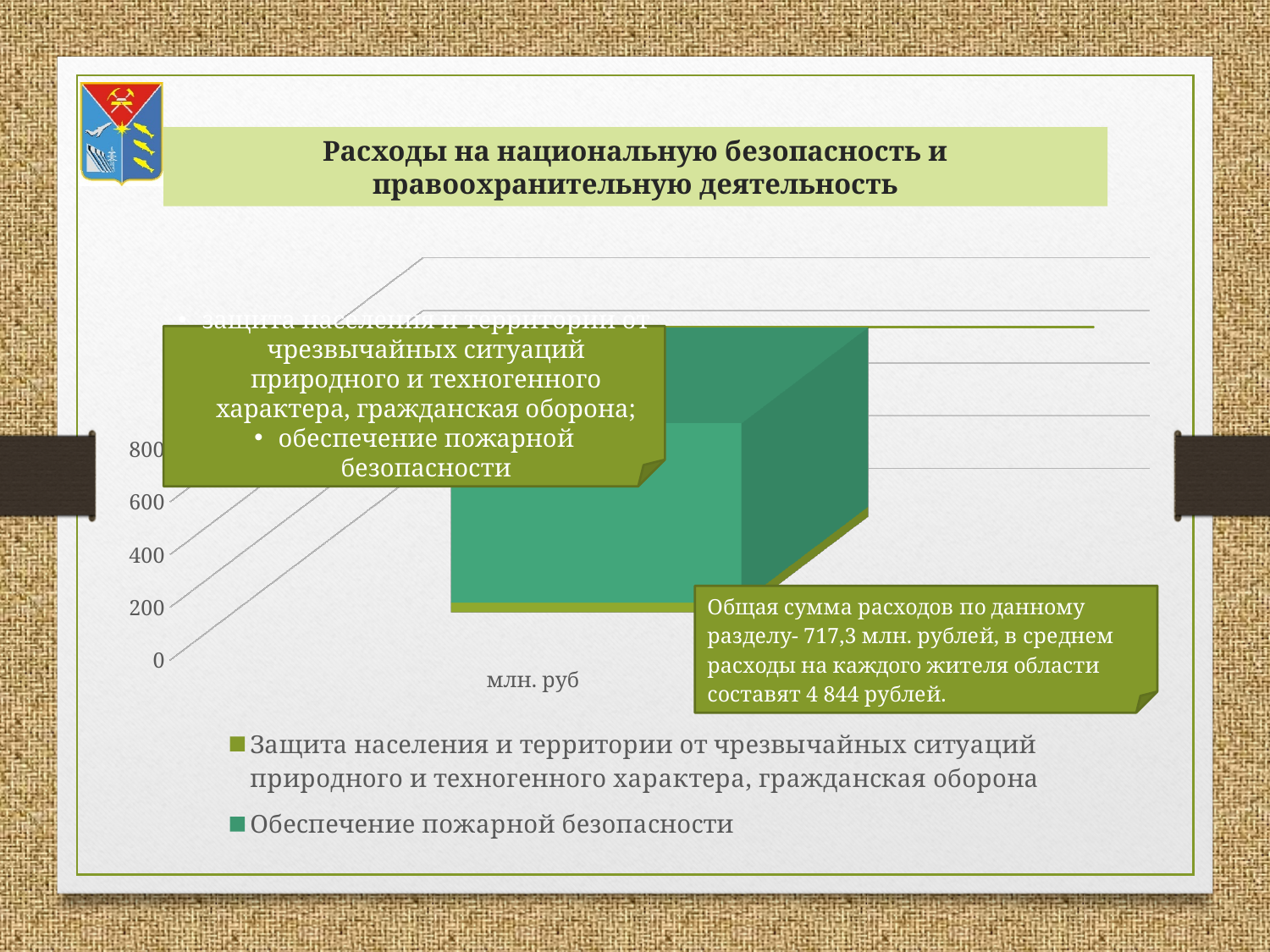
What is the highest value shown on the vertical axis? 800 How many categories are plotted on the x axis of the chart? 1 What is the title of the chart? Расходы на национальную безопасность и правоохранительную деятельность How many series does the chart legend list? 2 What is the label of the single category on the x axis? млн. руб Is the value for Обеспечение пожарной безопасности greater or less than 200? greater Is the total height of the stacked bar greater or less than 400? greater What kind of chart is shown on the slide? bar chart